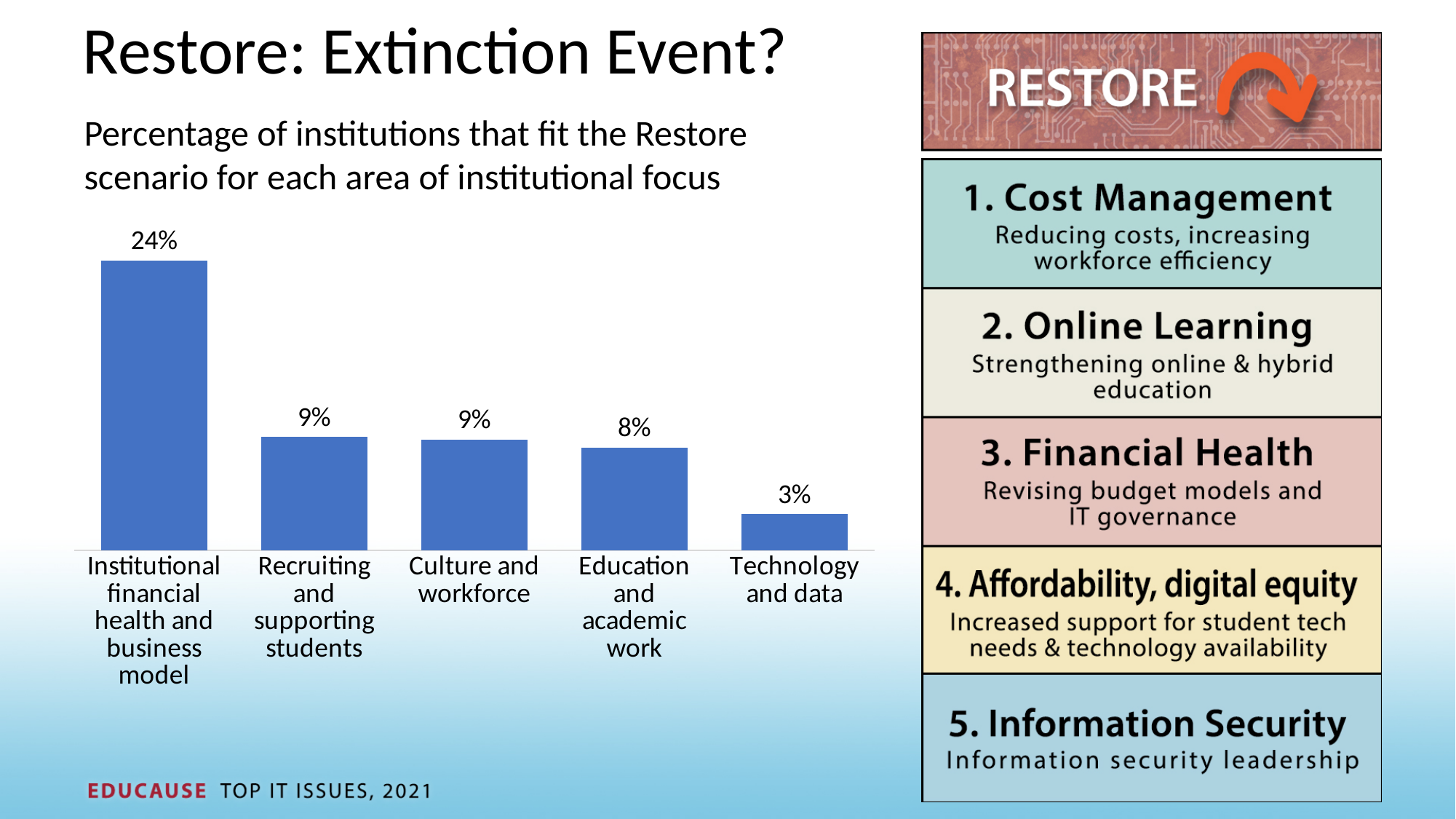
What is the difference between the values for Institutional financial health and business model and Technology and data? 21% Which is larger, the value for Education and academic work or the value for Technology and data? Education and academic work Which area of institutional focus has the highest percentage? Institutional financial health and business model What is the value for Technology and data? 3% What percentage of institutions fit the Restore scenario for Institutional financial health and business model? 24% What is the difference between the values for Culture and workforce and Education and academic work? 1% What kind of chart is shown on the slide? Bar chart Which area of institutional focus has the lowest percentage? Technology and data What is the value for Recruiting and supporting students? 9% What is the value for Education and academic work? 8% Do the values generally rise or fall from left to right across the chart? Fall How many areas of institutional focus are shown in the chart? 5